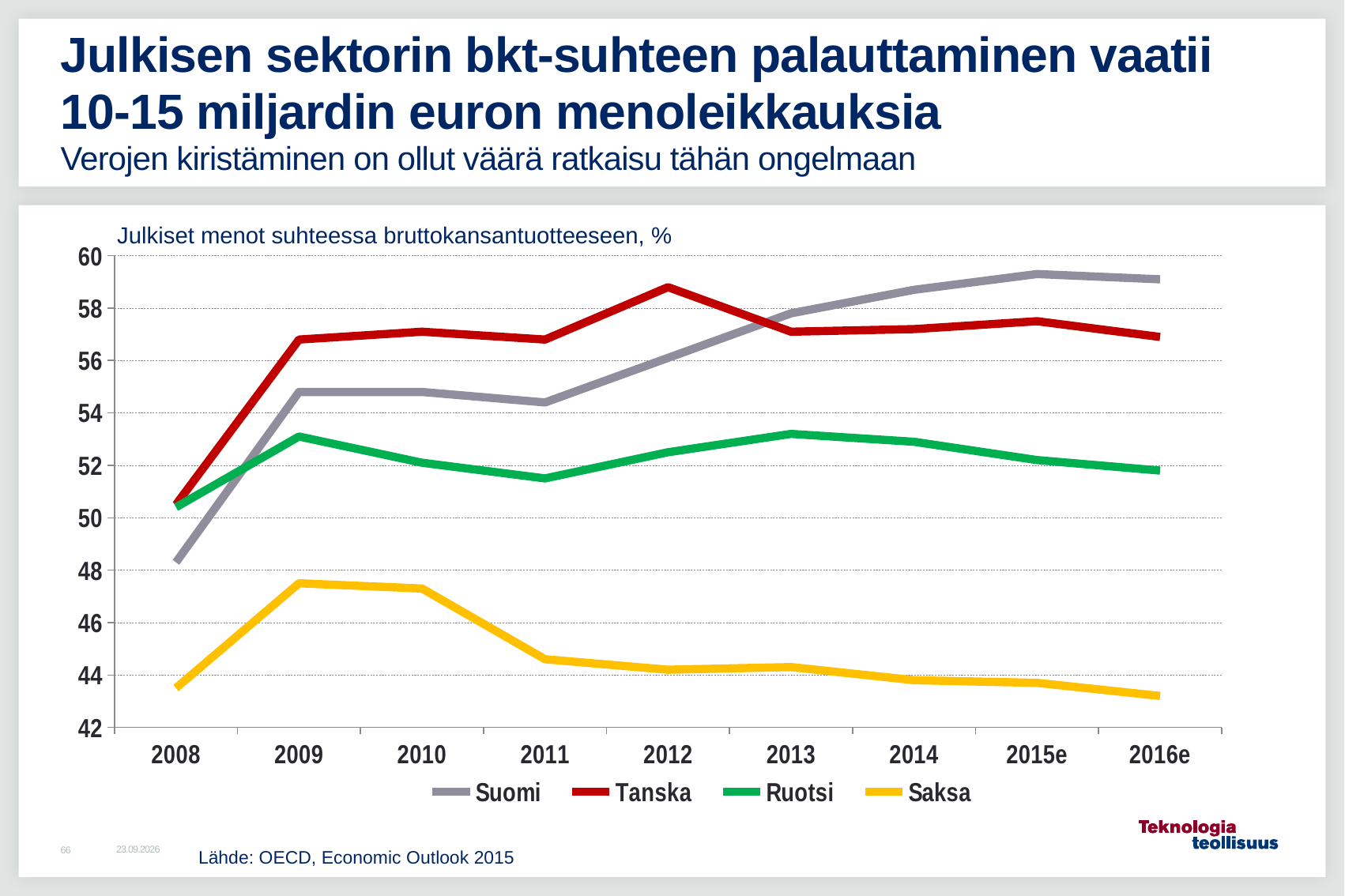
Which country has the lowest value in 2012? Saksa How many series does the legend list? 4 How many years are shown on the x axis? 9 Which country has the highest value in 2016e? Suomi What kind of chart is shown on the slide? line chart In 2012, which is larger: the value for Tanska or the value for Suomi? Tanska Is the value for Ruotsi in 2013 greater or less than 52? greater Is the value for Saksa in 2009 greater or less than 46? greater Does the value for Suomi rise or fall from 2008 to 2015e? rise Does the value for Saksa rise or fall from 2009 to 2016e? fall Is the value for Suomi in 2008 greater or less than 50? less What is the source cited for the chart? OECD, Economic Outlook 2015